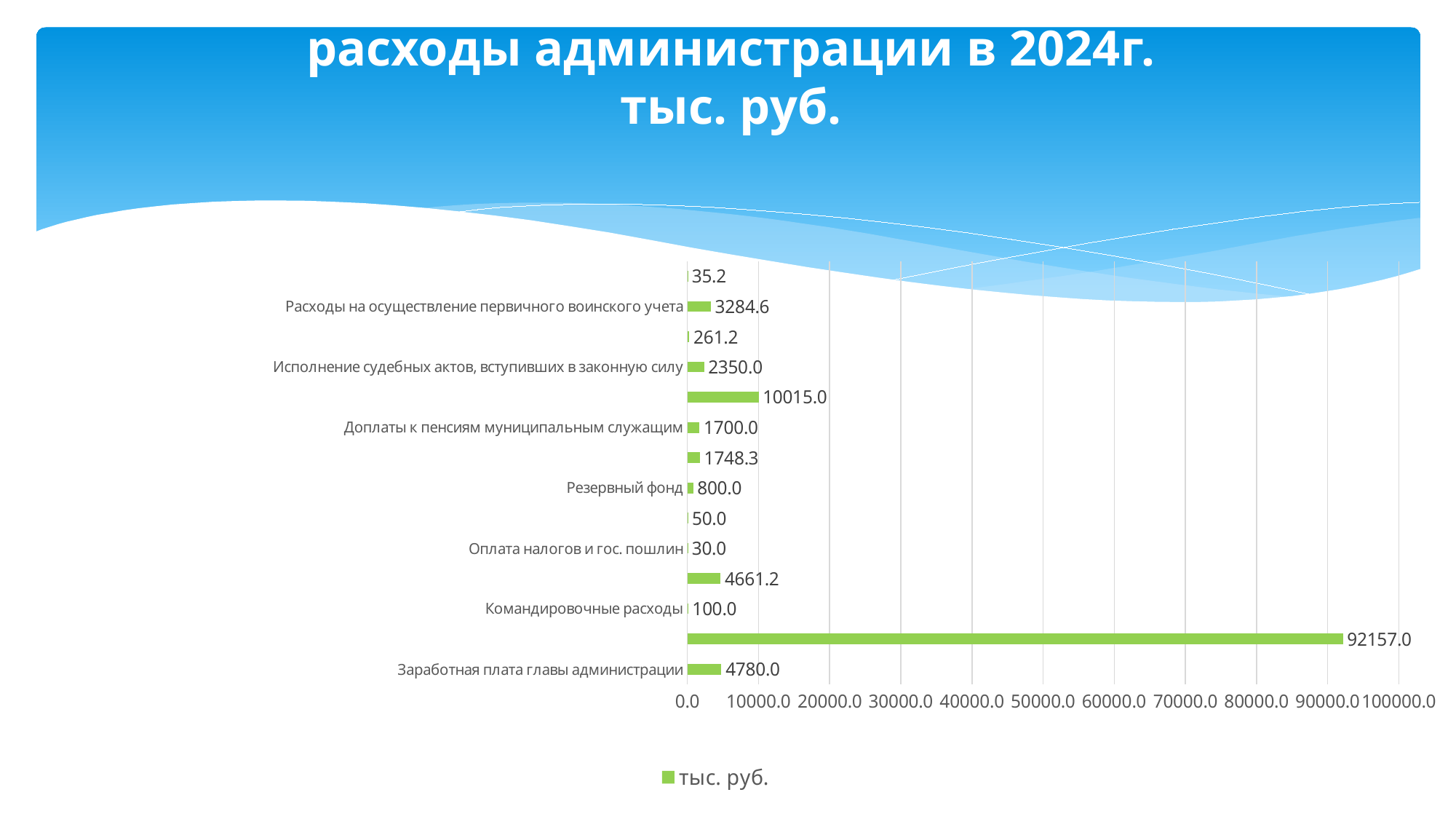
What is the value for Доплаты к пенсиям муниципальным служащим? 1700.0 What kind of chart is shown on the slide? bar chart What is the value for Расходы на осуществление первичного воинского учета? 3284.6 What is the largest value labelled on the chart? 92157.0 Which is larger: Резервный фонд or Оплата налогов и гос. пошлин? Резервный фонд Is the value for Исполнение судебных актов, вступивших в законную силу greater or less than 10000.0? less What is the value for Оплата налогов и гос. пошлин? 30.0 What is the value for Командировочные расходы? 100.0 What is the difference between Заработная плата главы администрации and Расходы на осуществление первичного воинского учета? 1495.4 How many bars are plotted on the chart? 14 What is the value for Резервный фонд? 800.0 What is the value for Заработная плата главы администрации? 4780.0